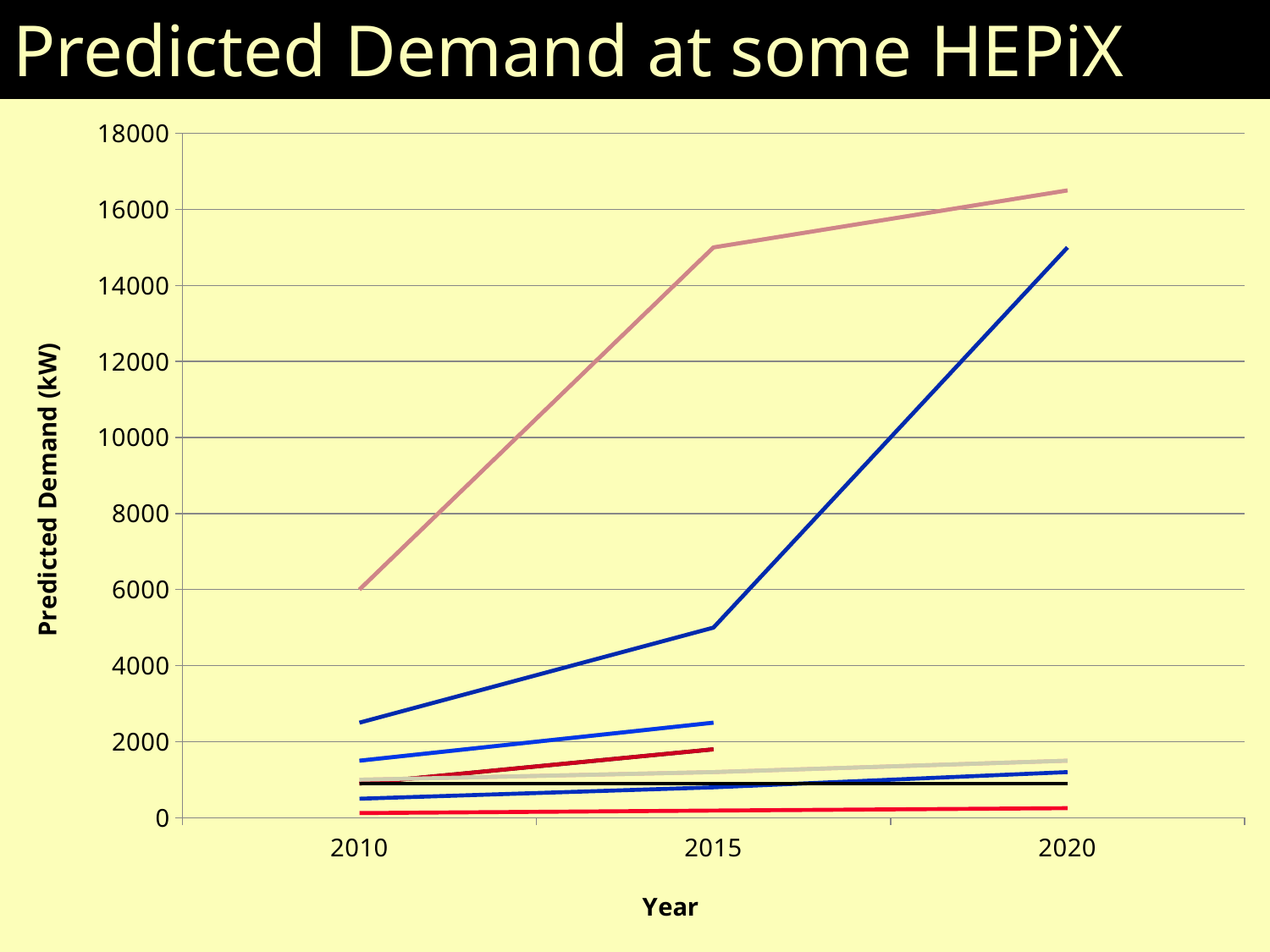
Is the value of the dark blue line in 2015 greater or less than 4000? greater Which line has the highest predicted demand in 2020? the pink line What is the label of the vertical axis? Predicted Demand (kW) Does the pink (top) line rise or fall from 2010 to 2020? rise What kind of chart is shown on the slide? line chart How many years are marked on the x axis? 3 Is the value of the pink (top) line in 2015 greater or less than 14000? greater Is the value of the dark blue line in 2020 greater or less than 16000? less In 2015, which is larger: the pink line or the dark blue line? the pink line What is the title of the chart on the slide? Predicted Demand at some HEPiX What is the value of the pink (top) line in 2010? 6000